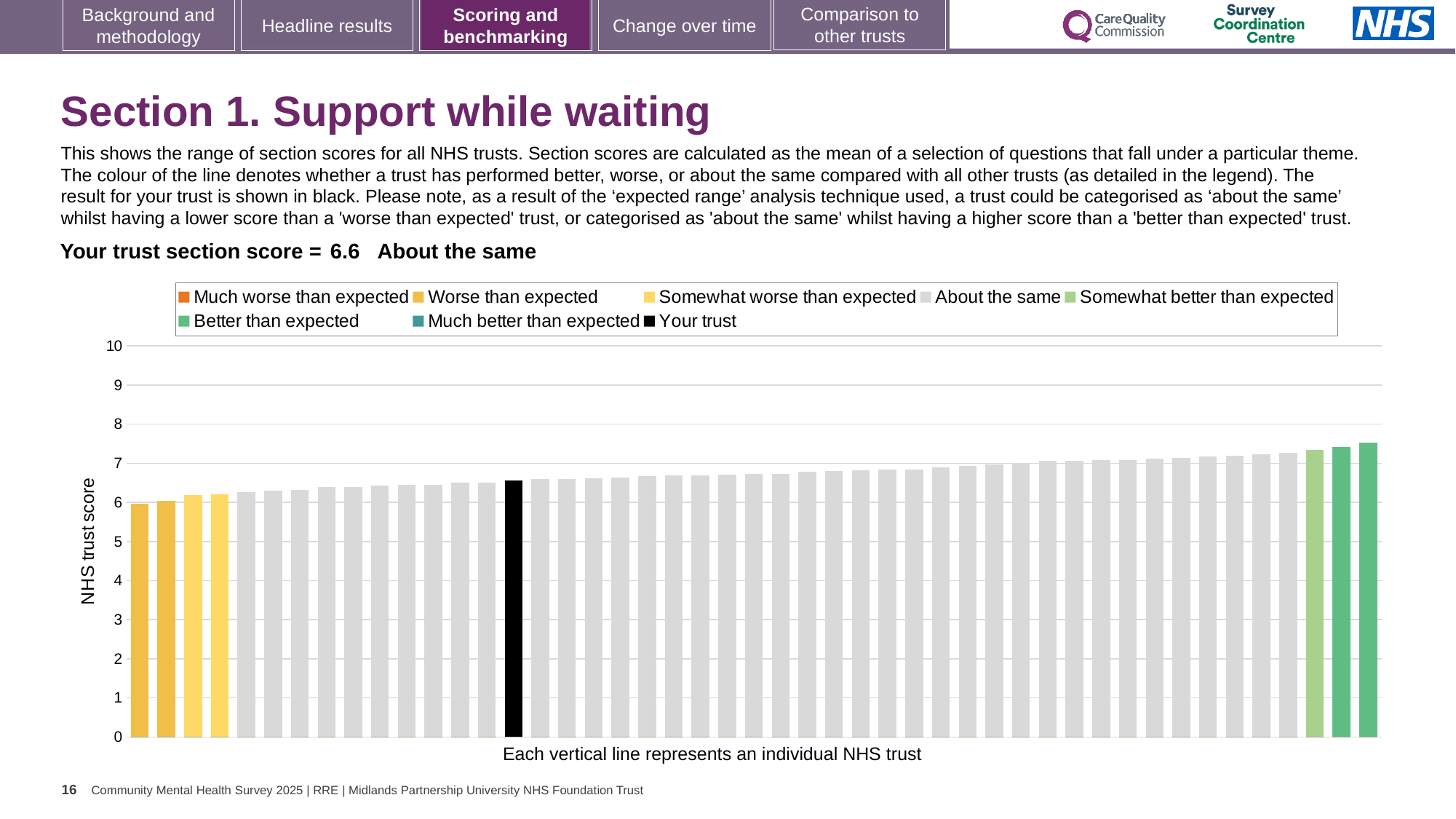
What kind of chart is shown on the slide? bar chart Is the value of the shortest bar (leftmost) greater or less than 7? less Is the value of the black 'Your trust' bar greater or less than 6? greater What is the label on the vertical axis of the chart? NHS trust score How many bars are coloured as 'Better than expected' (green)? 2 Is the value of the tallest bar (rightmost) greater or less than 7? greater What colour is the bar representing your trust? black How many entries does the chart legend list? 8 What is your trust's section score for Support while waiting? 6.6 How many bars are coloured as 'Worse than expected' (dark yellow)? 2 Which category is your trust placed in for this section? About the same Do the bar values rise or fall from left to right along the x axis? rise